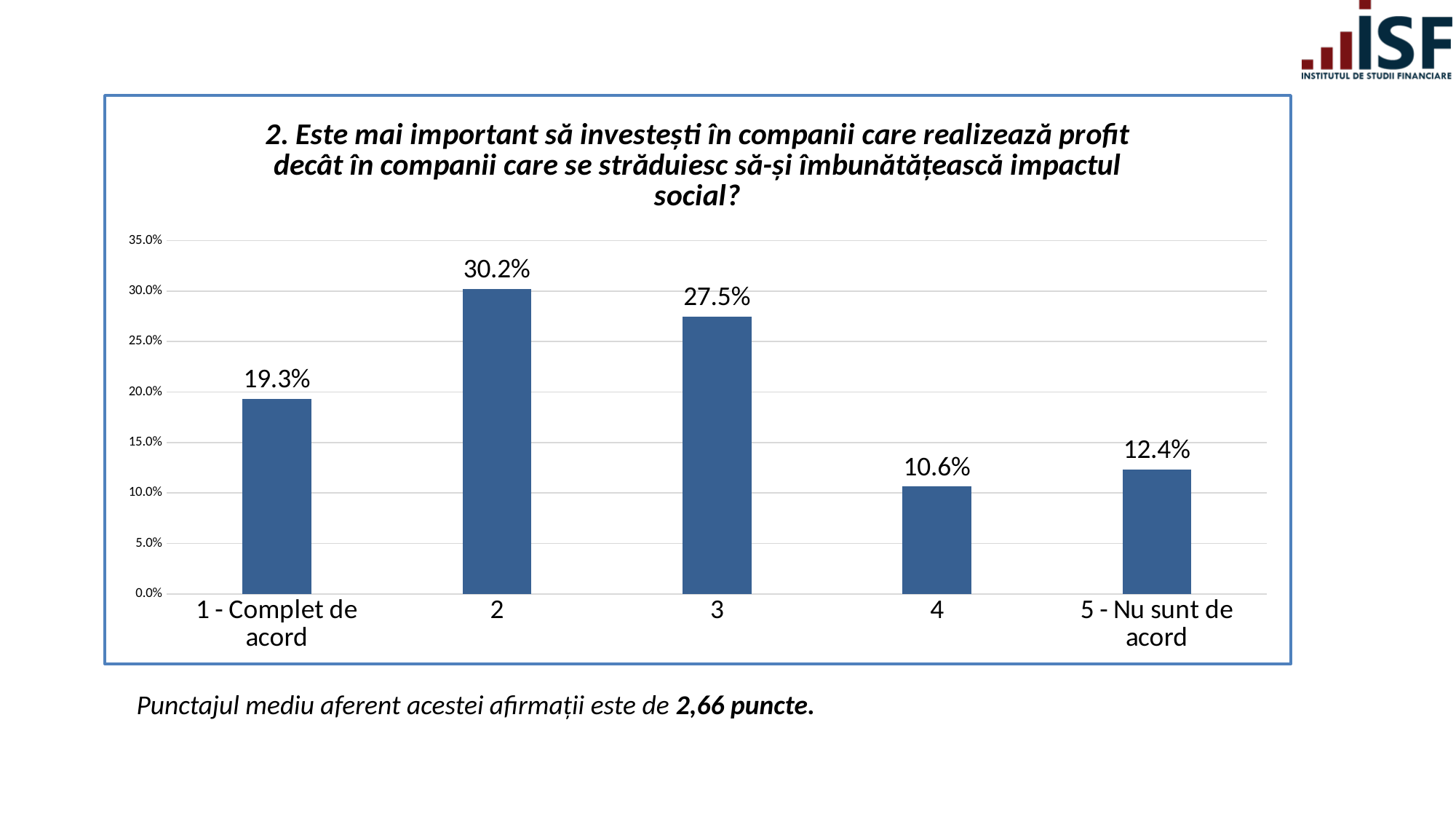
Is the value for category "3" greater or less than 25.0%? greater Which is larger, the value for "1 - Complet de acord" or the value for "5 - Nu sunt de acord"? 1 - Complet de acord What is the value for category "5 - Nu sunt de acord"? 12.4% What is the value for category "2"? 30.2% What kind of chart is shown on the slide? bar chart What is the highest value shown on the y axis? 35.0% How many categories are shown on the x axis? 5 What is the difference between the values for category "4" and category "5 - Nu sunt de acord"? 1.8% What is the value for category "1 - Complet de acord"? 19.3% What is the difference between the values for category "2" and category "3"? 2.7% Which category has the highest value? 2 Which category has the lowest value? 4